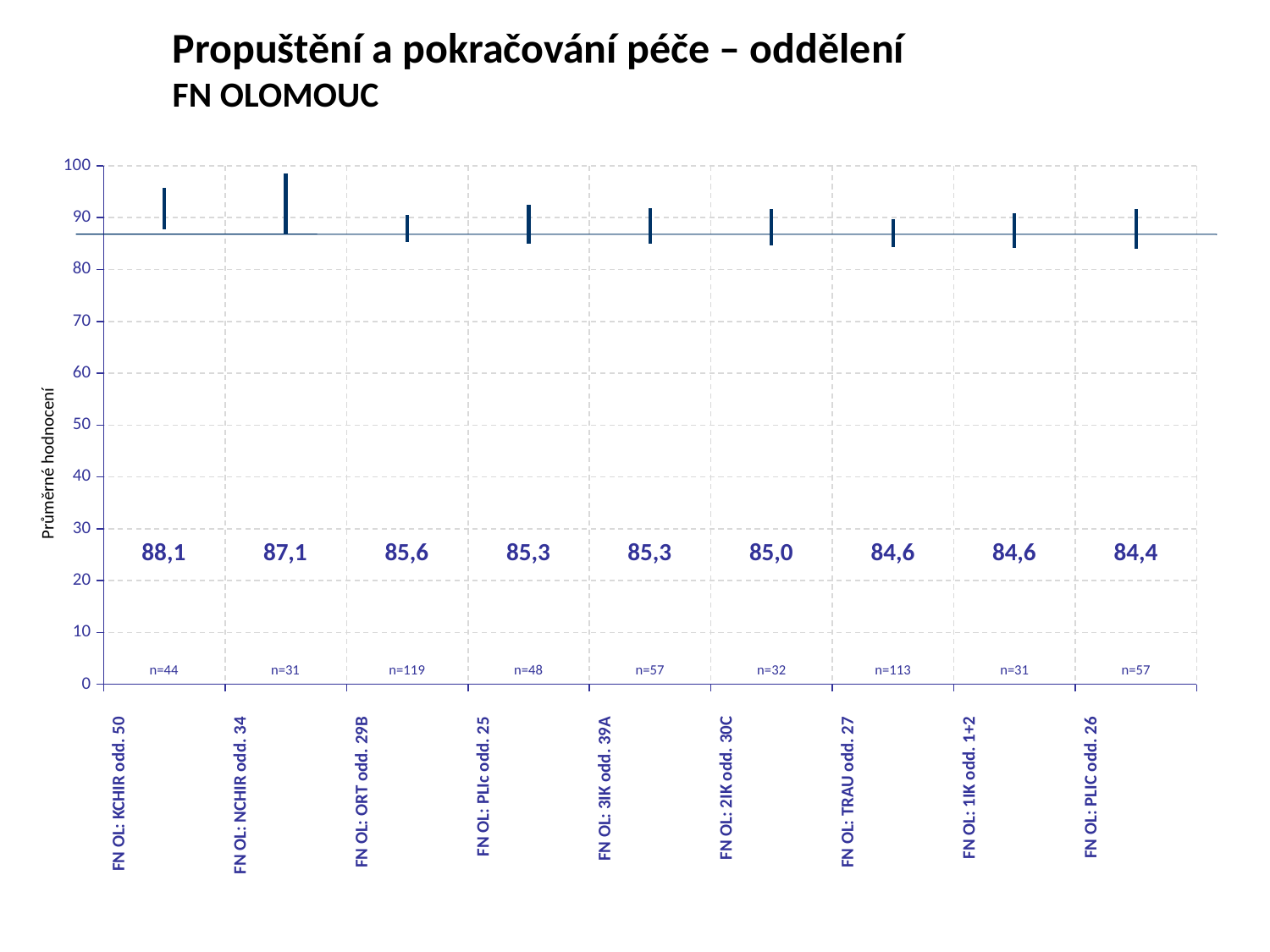
What is the label of the y axis? Průměrné hodnocení How many departments are shown on the chart? 9 Which has a higher average rating: FN OL: ORT odd. 29B or FN OL: 2IK odd. 30C? FN OL: ORT odd. 29B What is the average rating (průměrné hodnocení) for FN OL: KCHIR odd. 50? 88,1 What is the average rating for FN OL: PLIC odd. 26? 84,4 What is the difference between the average ratings of FN OL: KCHIR odd. 50 and FN OL: NCHIR odd. 34? 1,0 What is the average rating for FN OL: ORT odd. 29B? 85,6 Do the average ratings rise or fall from left to right along the x axis? fall Which department has the highest average rating? FN OL: KCHIR odd. 50 Which department has the largest number of respondents (n)? FN OL: ORT odd. 29B What is the number of respondents (n) for FN OL: TRAU odd. 27? n=113 Which department has the lowest average rating? FN OL: PLIC odd. 26